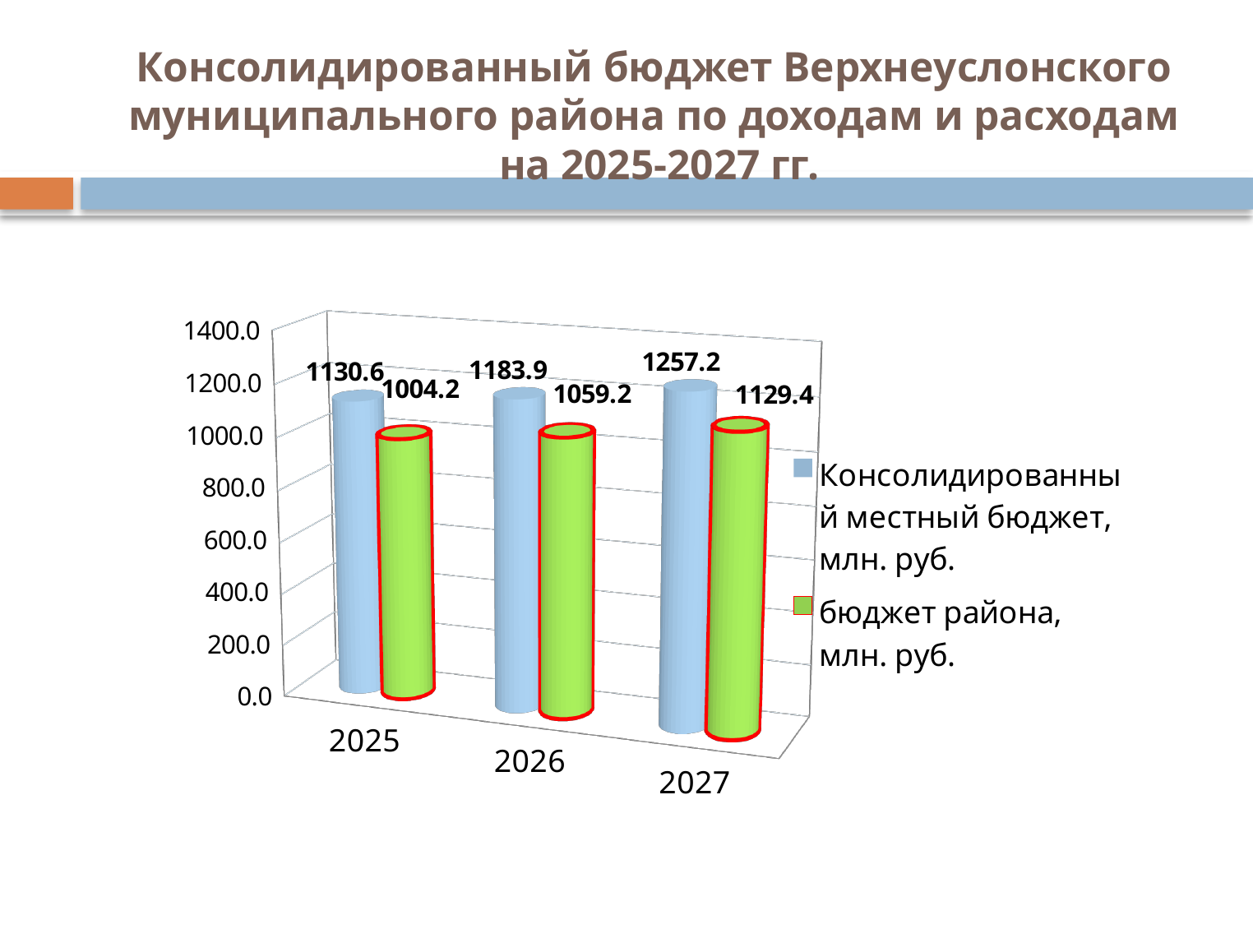
What is the value of the consolidated local budget (Консолидированный местный бюджет) for 2025? 1130.6 Which is larger in 2027: the consolidated local budget or the district budget? Консолидированный местный бюджет Is the district budget for 2025 greater or less than 1200.0? less How many years are shown on the x axis of the chart? 3 What is the value of the district budget (бюджет района) for 2027? 1129.4 What is the value of the district budget (бюджет района) for 2026? 1059.2 Does the consolidated local budget rise or fall from 2025 to 2027? rise How many series does the legend list? 2 In which year is the district budget the lowest? 2025 What is the difference between the consolidated local budget and the district budget in 2026? 124.7 By how much does the consolidated local budget grow from 2025 to 2027? 126.6 In which year is the consolidated local budget the highest? 2027